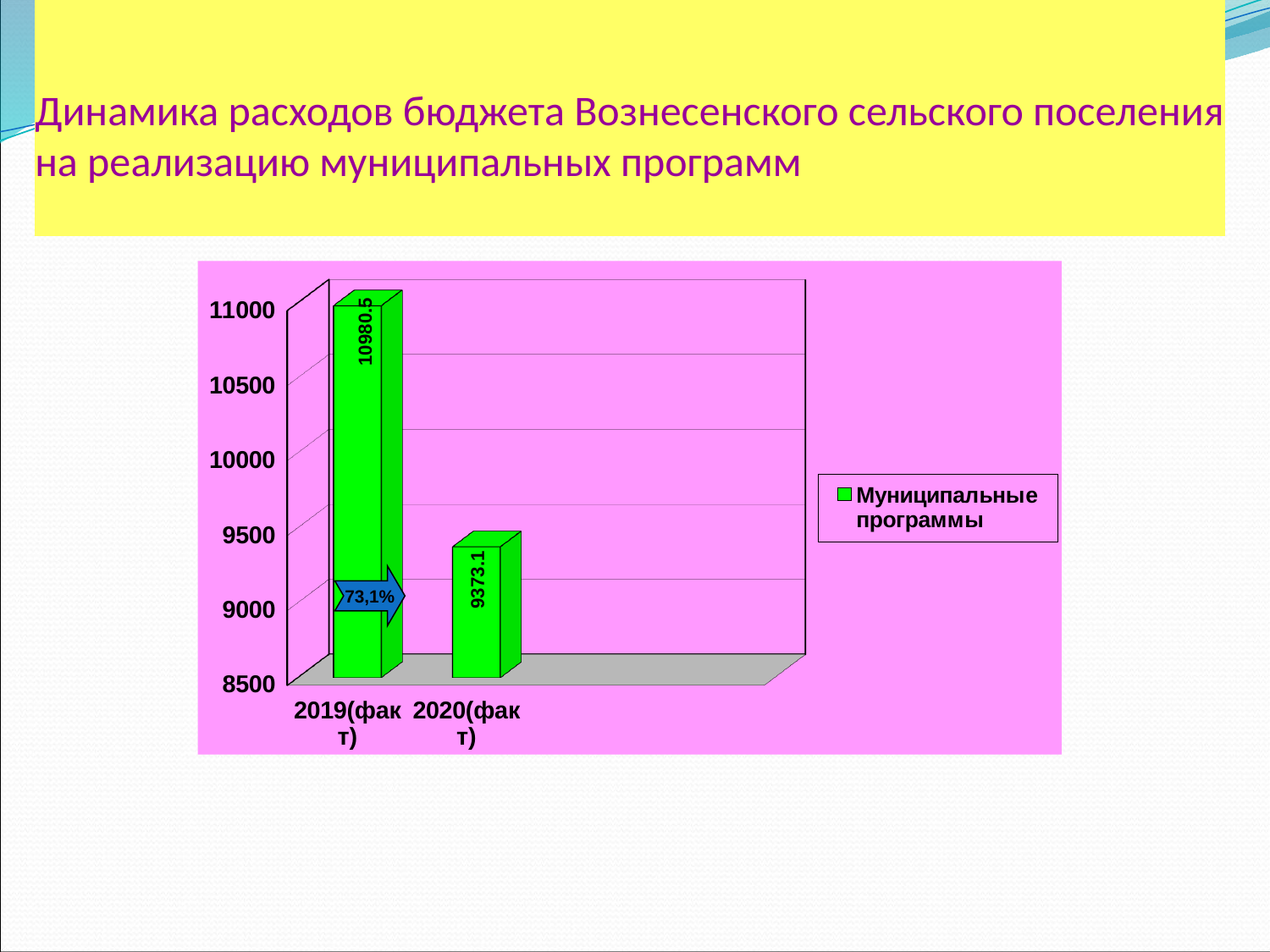
Which category has the highest value? 2019(факт) How many categories are shown on the x axis? 2 Is the value for 2020(факт) greater or less than 9500? less What is the value for 2020(факт)? 9373.1 What is the difference between the values for 2019(факт) and 2020(факт)? 1607.4 How many series does the legend list? 1 Which is larger, the value for 2019(факт) or the value for 2020(факт)? 2019(факт) Which category has the lowest value? 2020(факт) What is the value for 2019(факт)? 10980.5 What kind of chart is shown on the slide? bar chart What series name is shown in the legend? Муниципальные программы Is the value for 2019(факт) greater or less than 10500? greater